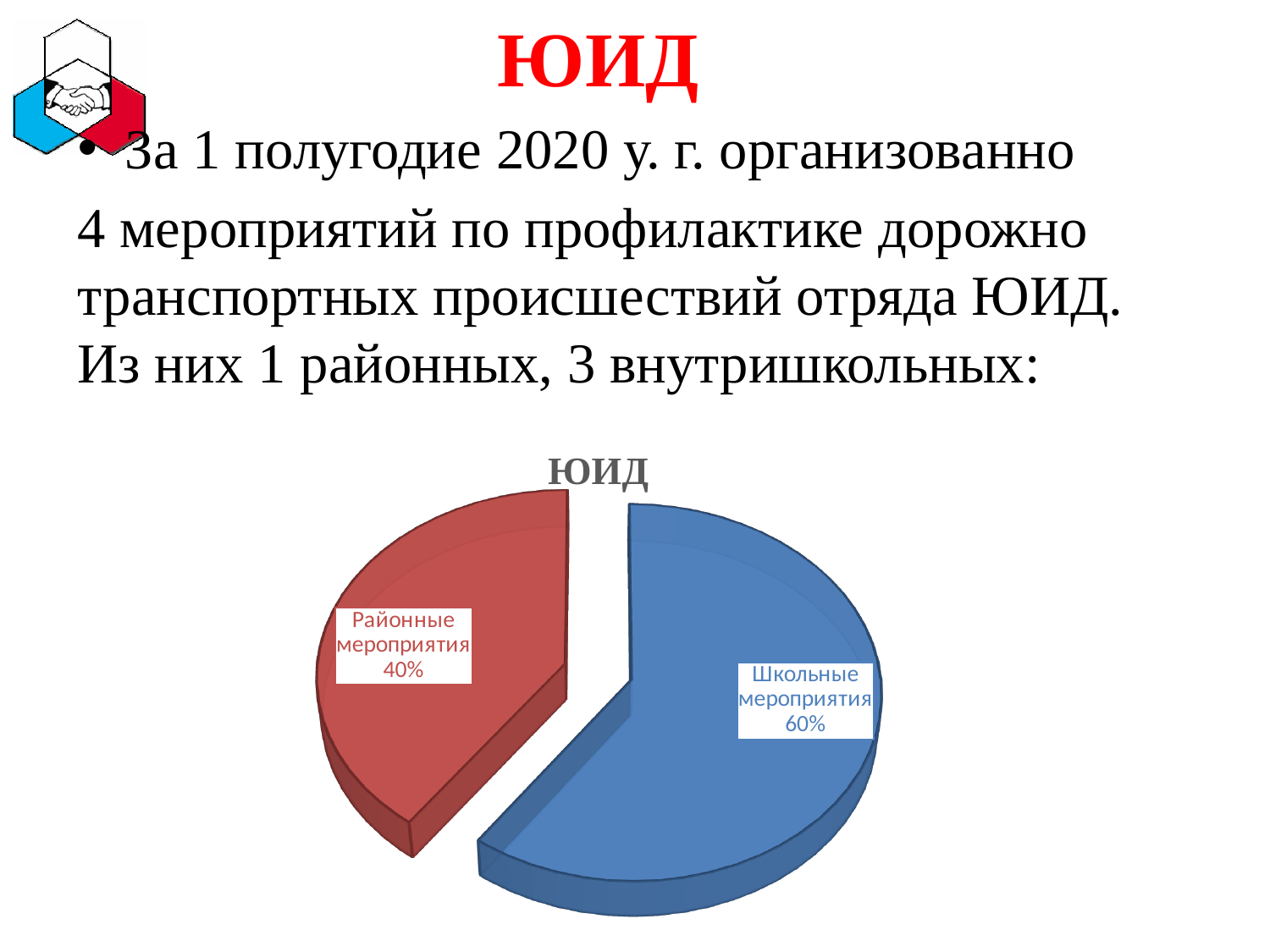
How many slices does the pie chart have? 2 What share of the pie is labelled Районные мероприятия? 40% What is the chart's title? ЮИД Which slice of the pie is the largest? Школьные мероприятия Is the share for Районные мероприятия greater or less than 50%? less What is the difference in percentage points between the Школьные мероприятия slice and the Районные мероприятия slice? 20% What share of the pie is labelled Школьные мероприятия? 60% What kind of chart is shown on the slide? pie chart Which slice of the pie is the smallest? Районные мероприятия Which is larger, the share for Школьные мероприятия or the share for Районные мероприятия? Школьные мероприятия What colour is the Школьные мероприятия slice? blue